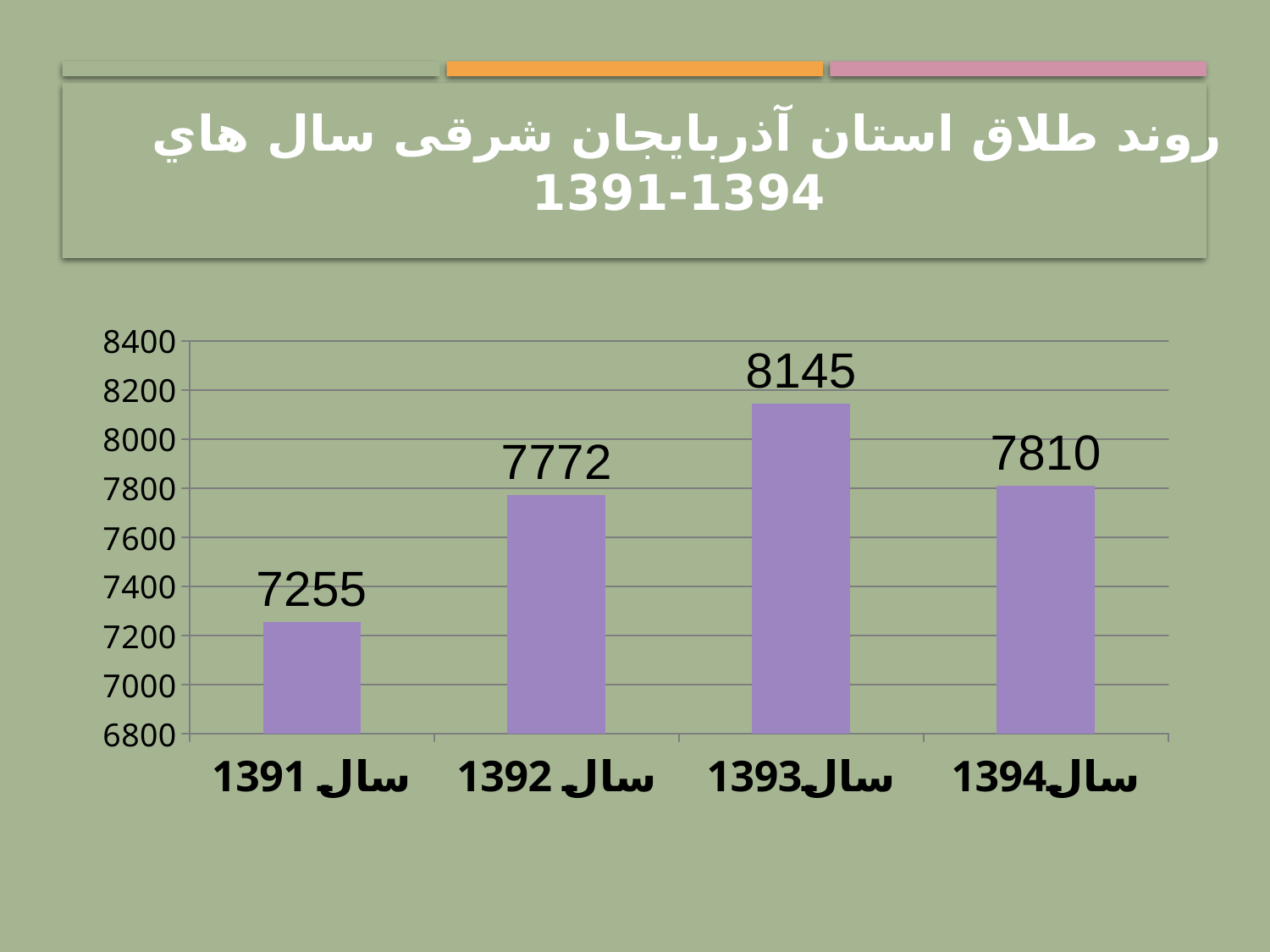
What kind of chart is shown on the slide? bar chart Which year has the highest value? سال 1393 What is the difference between the values for سال 1392 and سال 1394? 38 Which year has the lowest value? سال 1391 Do the values rise or fall from سال 1391 to سال 1393? rise What is the difference between the values for سال 1393 and سال 1391? 890 What is the value for سال 1391? 7255 Which is larger, the value for سال 1392 or the value for سال 1394? سال 1394 How many years are shown on the chart? 4 What is the value for سال 1393? 8145 Is the value for سال 1393 greater or less than 8000? greater What is the value for سال 1394? 7810